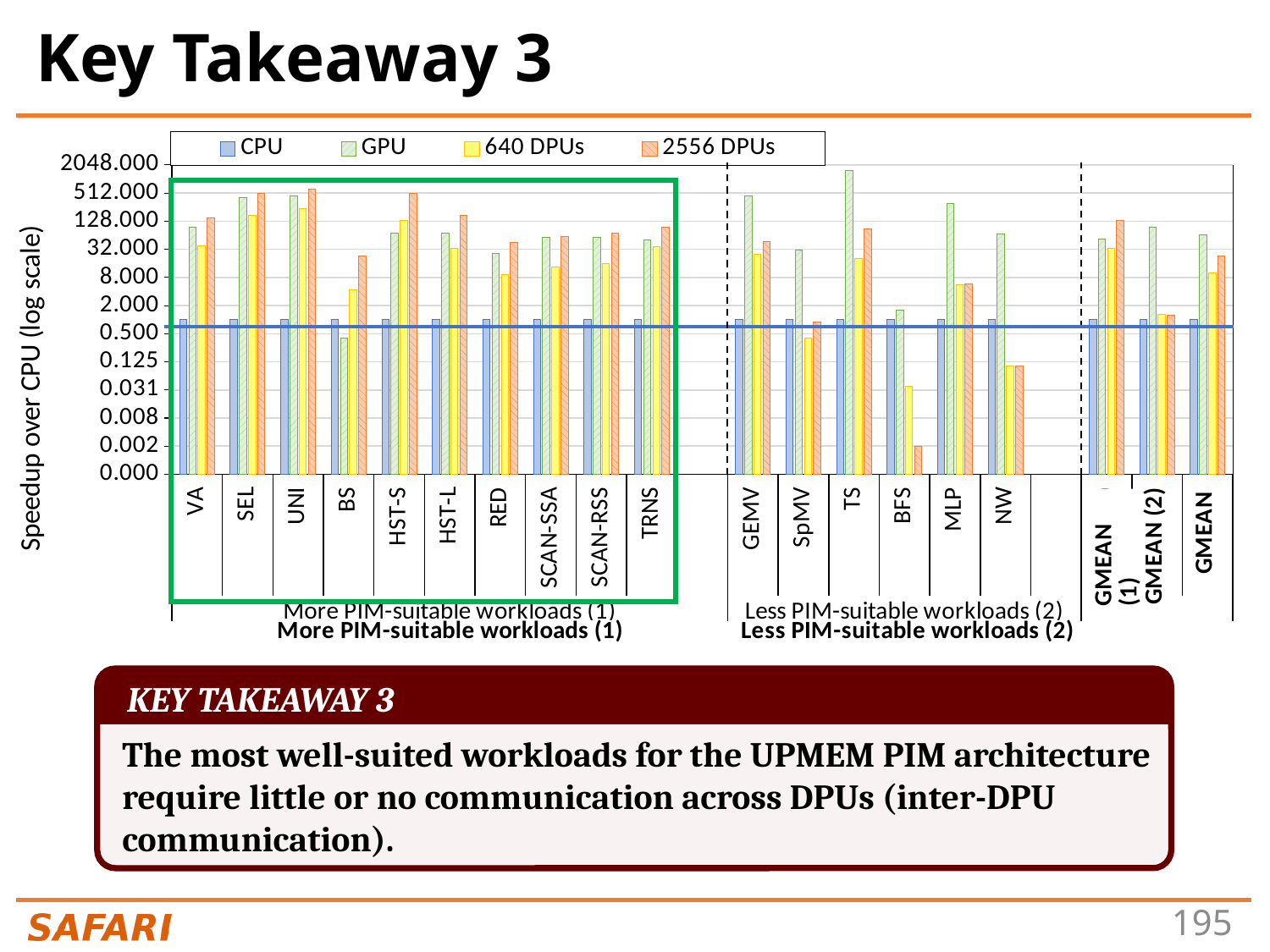
What kind of chart is shown on the slide? bar chart Which series has the highest bar for TS? GPU Is the 2556 DPUs value for BFS greater or less than 0.031? less How many series does the legend list? 4 Is the GPU value for TS greater or less than 512? greater What is the label of the y axis? Speedup over CPU (log scale) Is the GPU value for GEMV greater or less than 128? greater For BS, which is larger: the GPU bar or the 2556 DPUs bar? 2556 DPUs Among all workloads, which one has the highest GPU bar? TS Which workload has the lowest 2556 DPUs bar? BFS For NW, which is larger: the GPU bar or the 640 DPUs bar? GPU